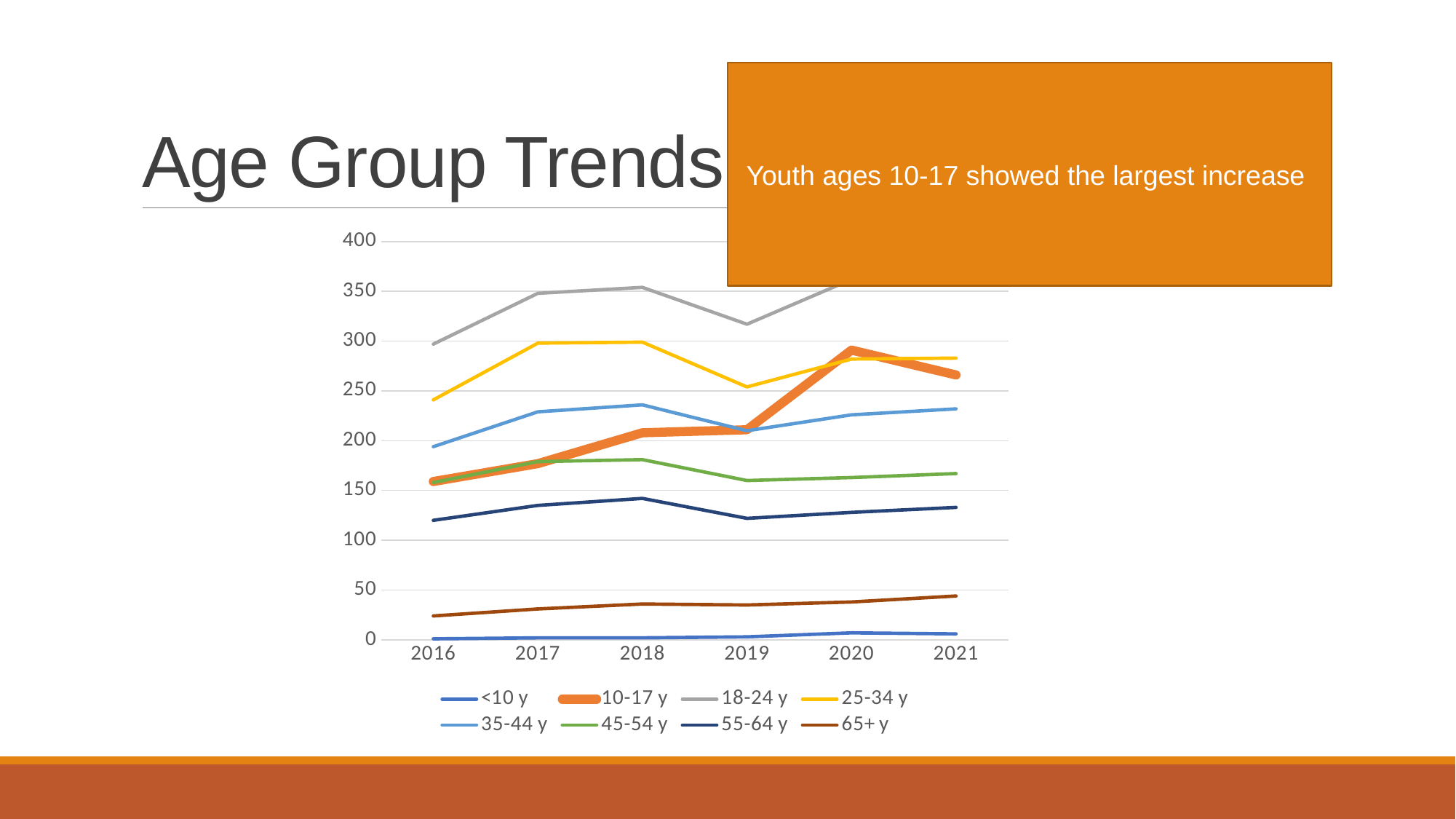
In 2018, which is larger: 25-34 y or 35-44 y? 25-34 y Is the value for 10-17 y in 2020 greater or less than 250? greater Is the value for 55-64 y in 2018 greater or less than 100? greater Which age group has the lowest values across all years? <10 y How many series does the legend list? 8 Which age group has the highest value in 2017? 18-24 y What does the orange callout box on the slide say? Youth ages 10-17 showed the largest increase Is the value for 18-24 y in 2016 greater or less than 250? greater How many years are plotted along the x axis? 6 In 2021, which is larger: 35-44 y or 45-54 y? 35-44 y What kind of chart is shown on the slide? line chart